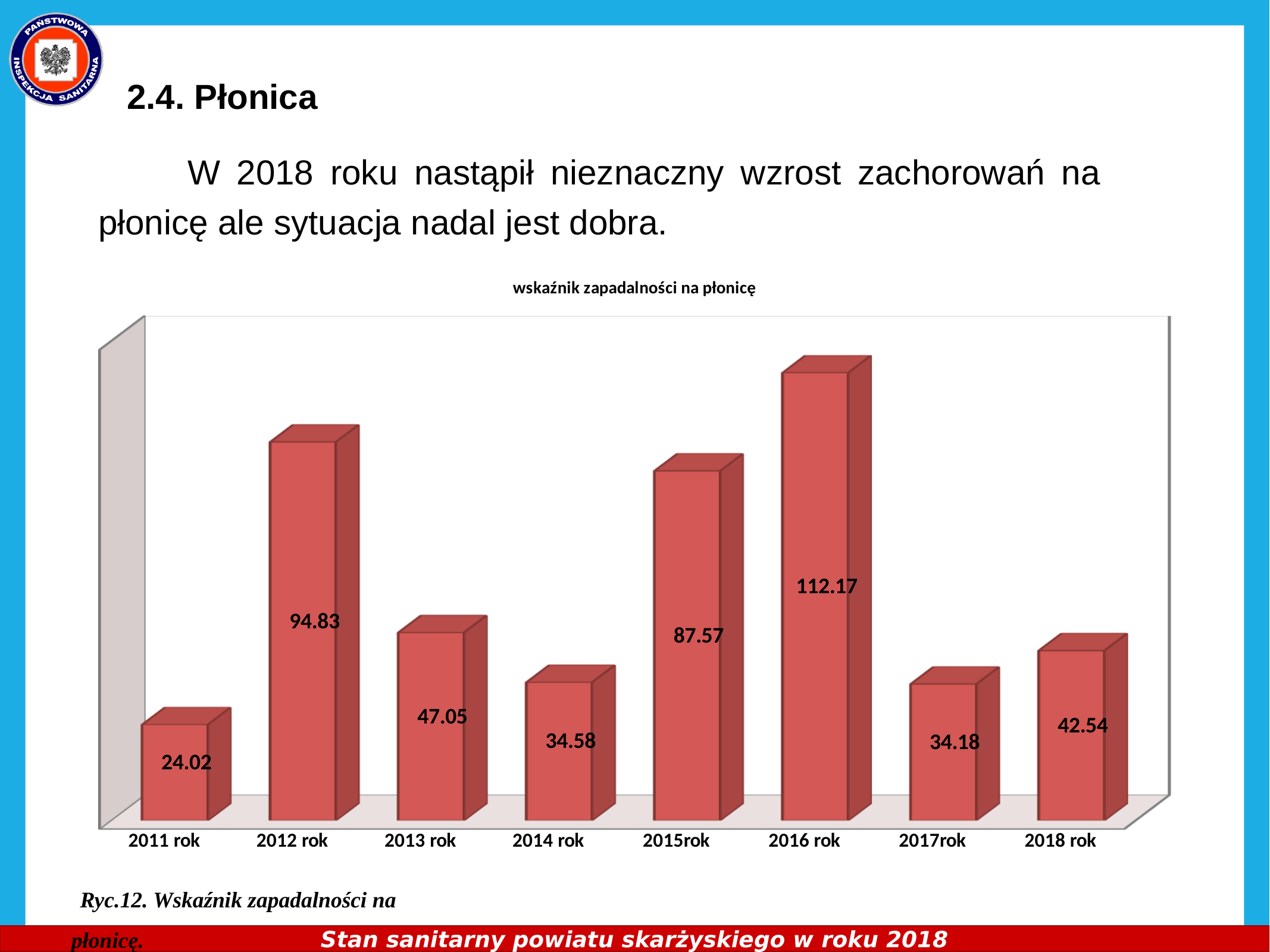
What kind of chart is shown on the slide? bar chart What is the difference between the values for 2018 rok and 2017rok? 8.36 Which year has the highest value in the chart? 2016 rok Which year has the lowest value in the chart? 2011 rok Which is larger, the value for 2012 rok or the value for 2015rok? 2012 rok What is the value for 2018 rok in the chart? 42.54 How many years are shown on the x axis of the chart? 8 What is the value for 2011 rok in the chart? 24.02 What is the difference between the values for 2016 rok and 2011 rok? 88.15 What is the value for 2015rok in the chart? 87.57 Which is larger, the value for 2013 rok or the value for 2018 rok? 2013 rok What is the title of the chart? wskaźnik zapadalności na płonicę